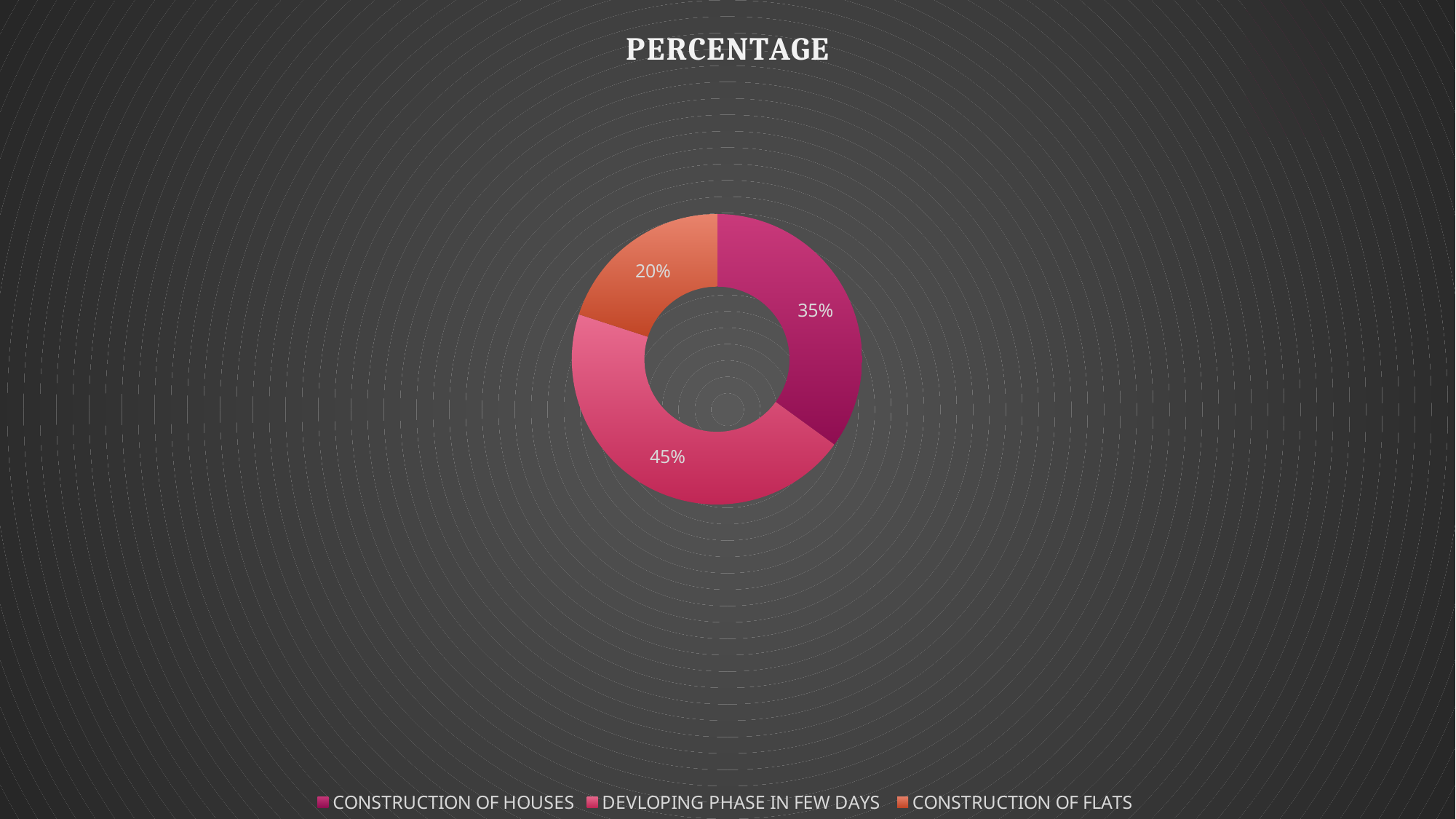
What is the combined share of CONSTRUCTION OF HOUSES and CONSTRUCTION OF FLATS? 55% What is the title of the chart? PERCENTAGE Which category has the smallest share? CONSTRUCTION OF FLATS What percentage is shown for CONSTRUCTION OF FLATS? 20% How many entries does the legend list? 3 What kind of chart is shown on the slide? doughnut chart Which is larger, the share for CONSTRUCTION OF HOUSES or the share for CONSTRUCTION OF FLATS? CONSTRUCTION OF HOUSES How many categories does the chart show? 3 What is the difference between the shares of DEVLOPING PHASE IN FEW DAYS and CONSTRUCTION OF HOUSES? 10% What percentage is shown for CONSTRUCTION OF HOUSES? 35% What percentage is shown for DEVLOPING PHASE IN FEW DAYS? 45% Which category has the largest share? DEVLOPING PHASE IN FEW DAYS